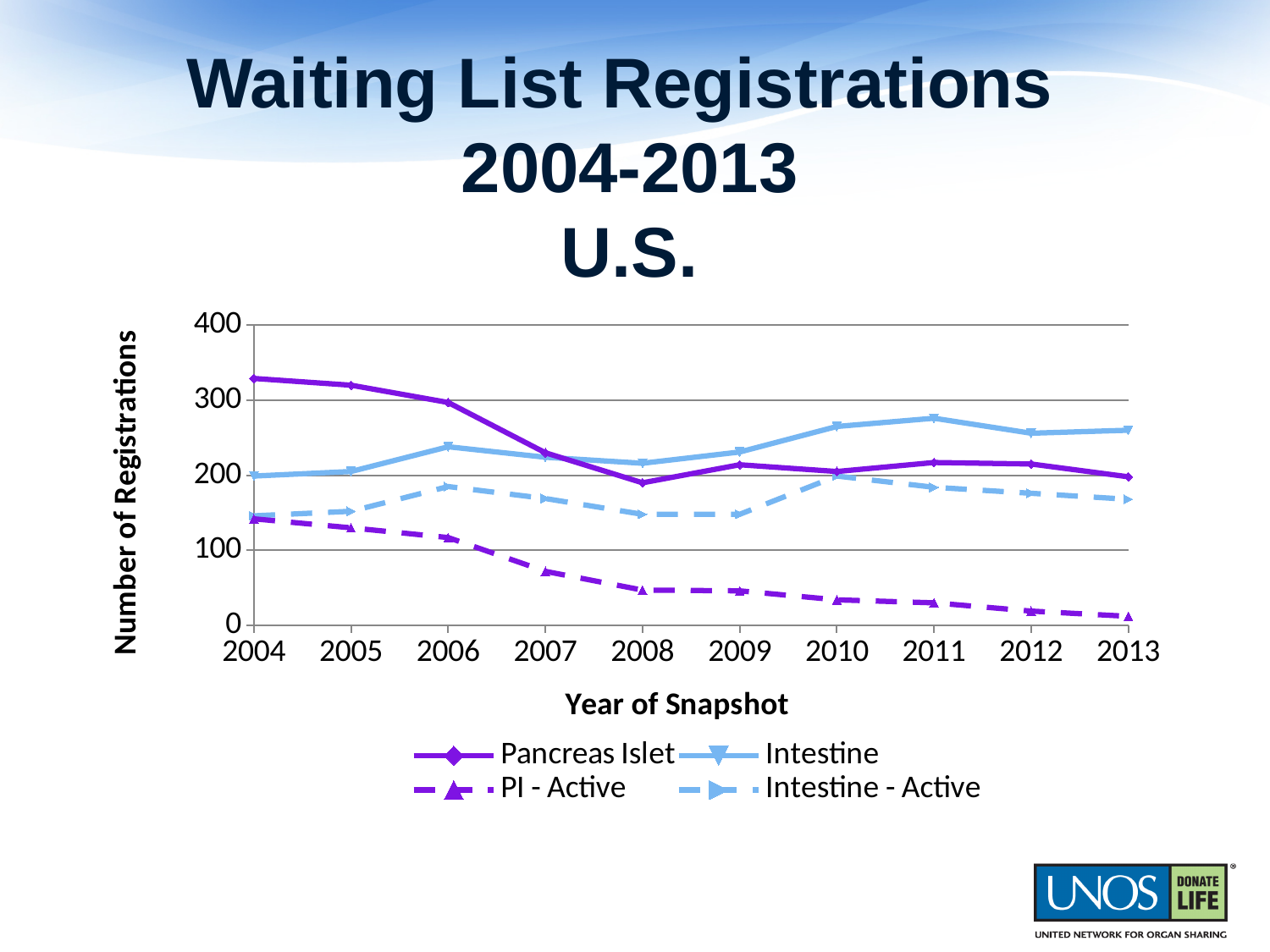
What is the label of the y axis? Number of Registrations Is the value for Intestine in 2011 greater or less than 300? less Is the value for Pancreas Islet in 2004 greater or less than 300? greater Does the PI - Active series rise or fall from 2004 to 2013? fall How many series does the legend list? 4 Is the value for PI - Active in 2013 greater or less than 100? less How many years are plotted along the x axis? 10 In 2013, which is larger: Intestine or Pancreas Islet? Intestine In which year is the PI - Active series at its lowest? 2013 In which year is the Pancreas Islet series at its highest? 2004 What kind of chart is shown on the slide? line chart